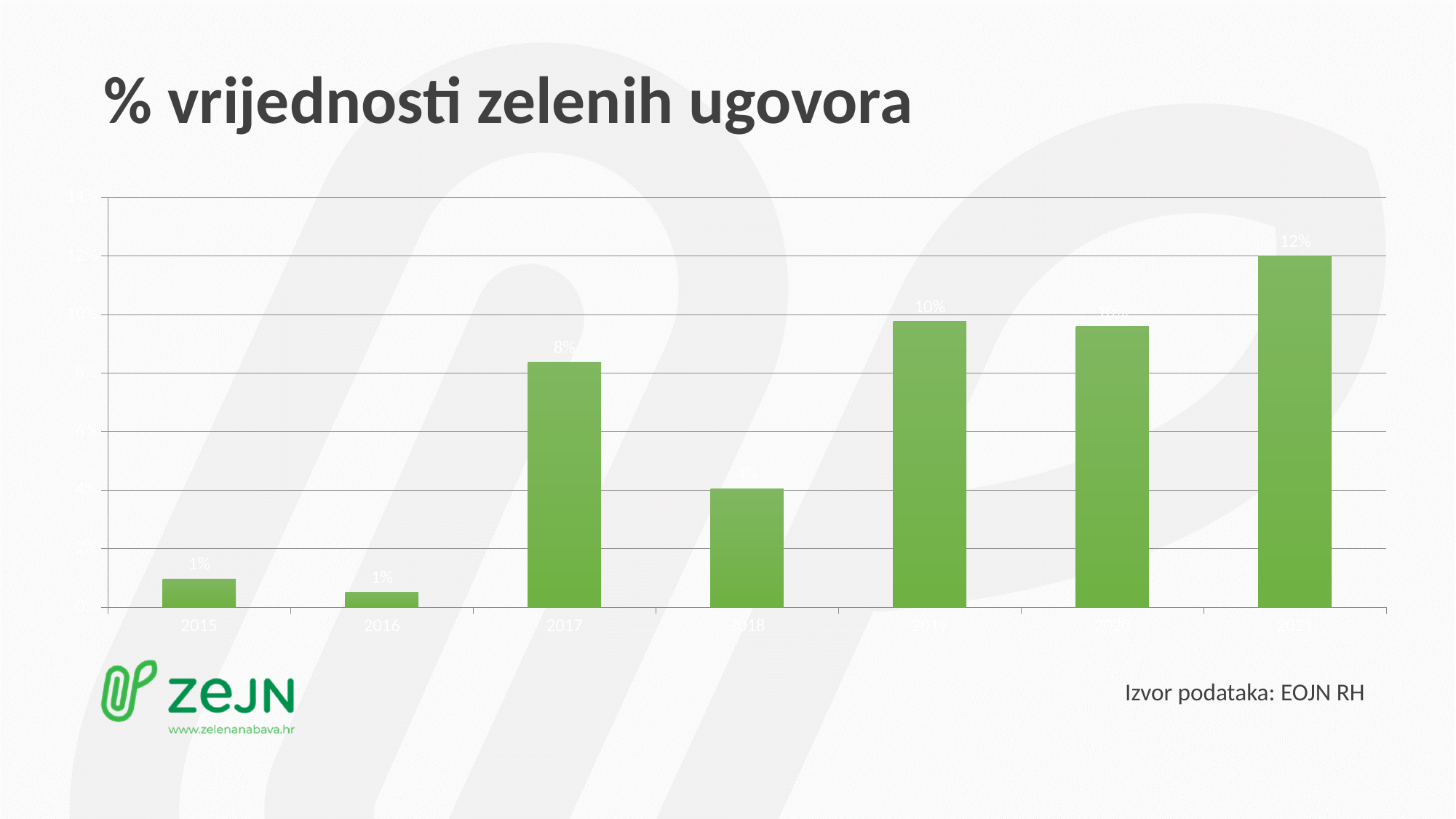
What is the value for 2019? 10% What type of chart is shown on the slide? bar chart What is the value for 2021? 12% How many years are shown on the x axis of the chart? 7 What is the title of the chart? % vrijednosti zelenih ugovora What is the value for 2018? 4% Which is larger, the value for 2018 or the value for 2019? 2019 What is the value for 2017? 8% What is the data source stated on the slide? EOJN RH Is the value for 2020 greater or less than 8%? greater Which year has the highest value? 2021 What is the difference between the values for 2021 and 2017? 4%